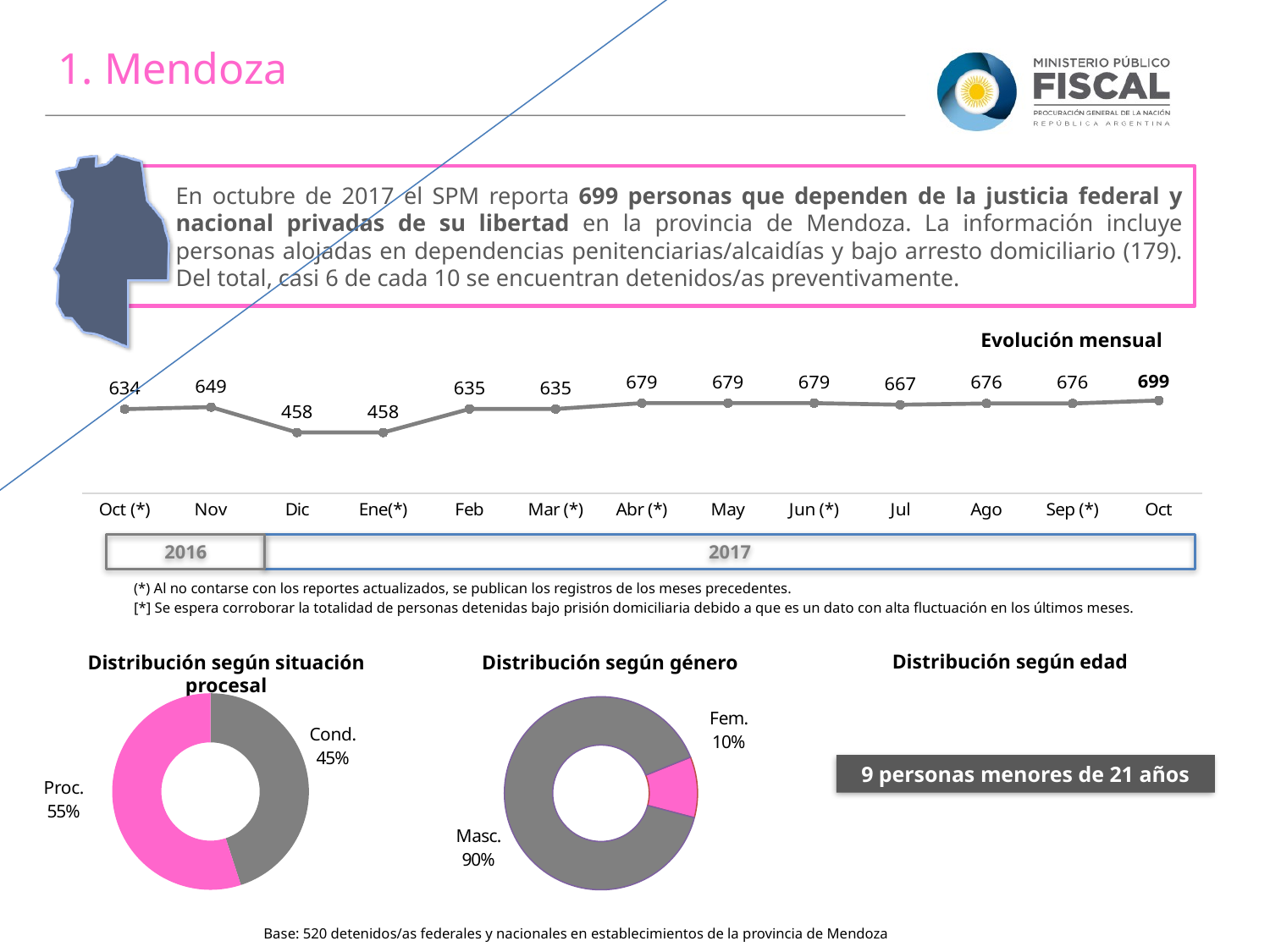
What kind of chart is 'Evolución mensual'? Line chart In the 'Evolución mensual' chart, which is larger, the value for Nov or the value for Feb? Nov In the 'Evolución mensual' chart, what is the difference between the Oct 2017 value and the Jul value? 32 In the 'Evolución mensual' chart, which month has the highest value? Oct (2017) In the 'Distribución según género' chart, what share is labelled Fem.? 10% In the 'Evolución mensual' chart, what is the lowest value plotted? 458 In the 'Evolución mensual' chart, what value is shown for Oct 2017? 699 How many data points are plotted in the 'Evolución mensual' chart? 13 In the 'Distribución según situación procesal' chart, what percentage is shown for Cond.? 45% In the 'Evolución mensual' chart, what value is shown for Dic? 458 In the 'Distribución según situación procesal' chart, what share is labelled Proc.? 55% In the 'Distribución según género' chart, which category is larger, Masc. or Fem.? Masc.